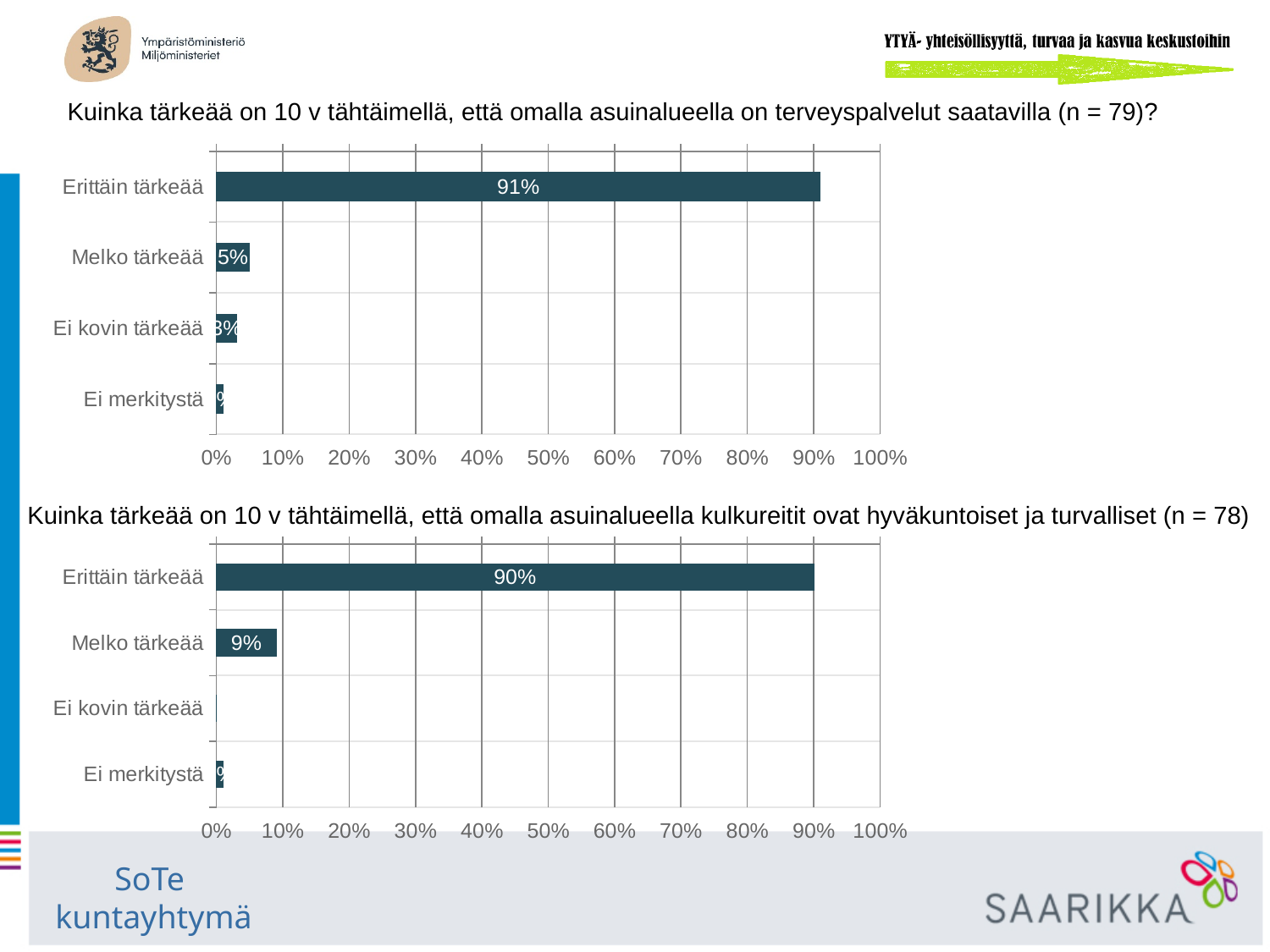
How many categories are shown in the bottom chart (kulkureitit hyväkuntoiset ja turvalliset, n = 78)? 4 In the top chart (terveyspalvelut saatavilla, n = 79), which category has the highest value? Erittäin tärkeää In the bottom chart (kulkureitit hyväkuntoiset ja turvalliset, n = 78), which category has the highest value? Erittäin tärkeää In the top chart (terveyspalvelut saatavilla, n = 79), is the value for Ei kovin tärkeää greater or less than 10%? less In the bottom chart (kulkureitit hyväkuntoiset ja turvalliset, n = 78), what is the value for Melko tärkeää? 9% In the bottom chart (kulkureitit hyväkuntoiset ja turvalliset, n = 78), what is the difference between Erittäin tärkeää and Melko tärkeää? 81% Which is larger: Melko tärkeää in the top chart (terveyspalvelut) or Melko tärkeää in the bottom chart (kulkureitit)? Bottom chart (kulkureitit), 9% What type of chart is the top chart (terveyspalvelut saatavilla, n = 79)? Bar chart In the top chart (terveyspalvelut saatavilla, n = 79), what is the value for Melko tärkeää? 5% In the bottom chart (kulkureitit hyväkuntoiset ja turvalliset, n = 78), what is the value for Erittäin tärkeää? 90% In the top chart (terveyspalvelut saatavilla, n = 79), what is the difference between Erittäin tärkeää and Melko tärkeää? 86% In the top chart (terveyspalvelut saatavilla, n = 79), what is the value for Erittäin tärkeää? 91%